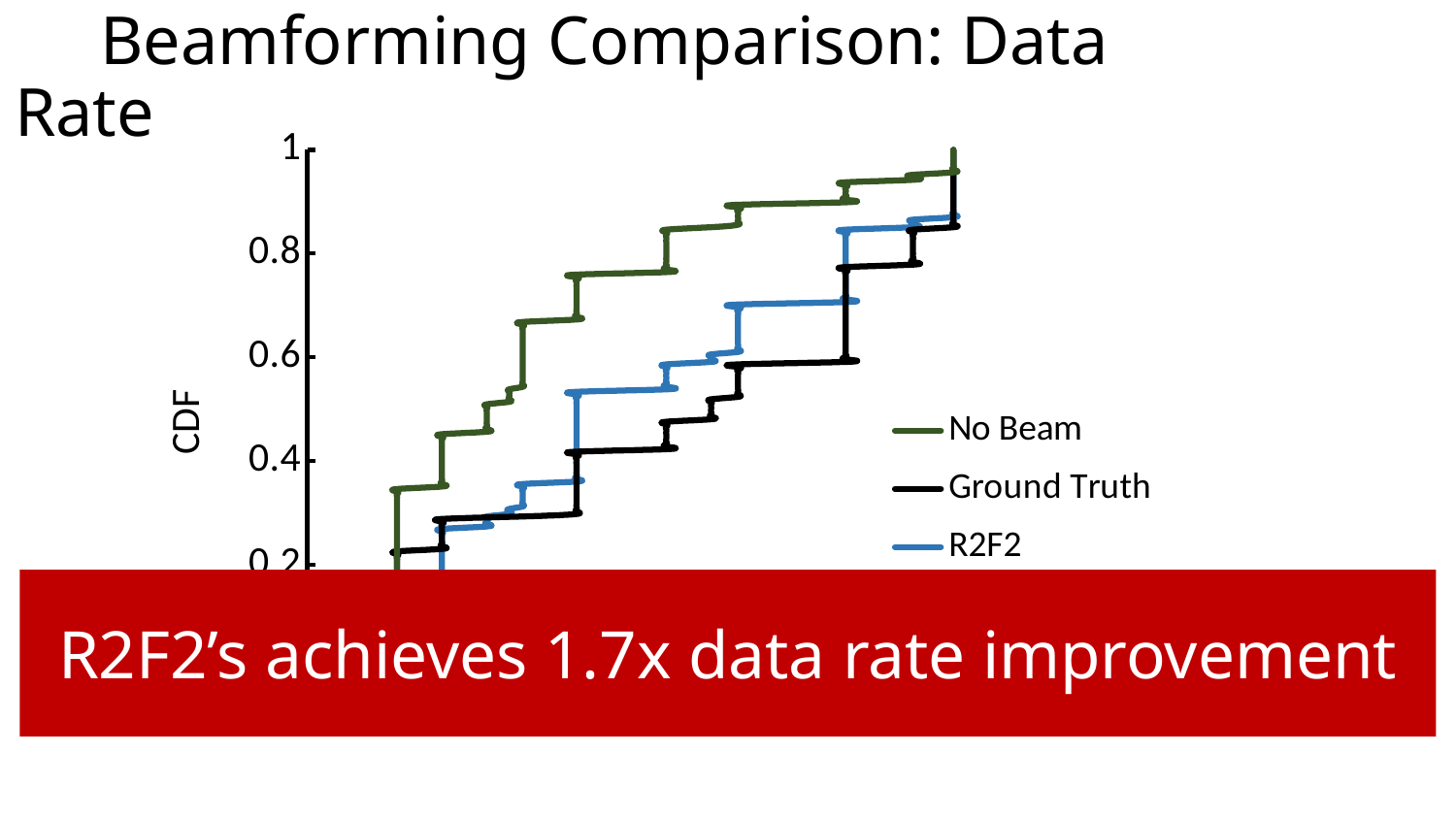
What is the title of the slide's chart? Beamforming Comparison: Data Rate Which series lies furthest to the left (reaches a given CDF value first) across the chart? No Beam Which series is drawn in black? Ground Truth How many series does the legend list? 3 What is the label on the y axis? CDF Which series is drawn in green in the legend? No Beam Do the plotted curves rise or fall as you move along the x axis? rise What is the highest tick value shown on the y axis? 1 Which series reaches the highest CDF value at the right end of the chart? No Beam What kind of chart is shown on the slide? line chart